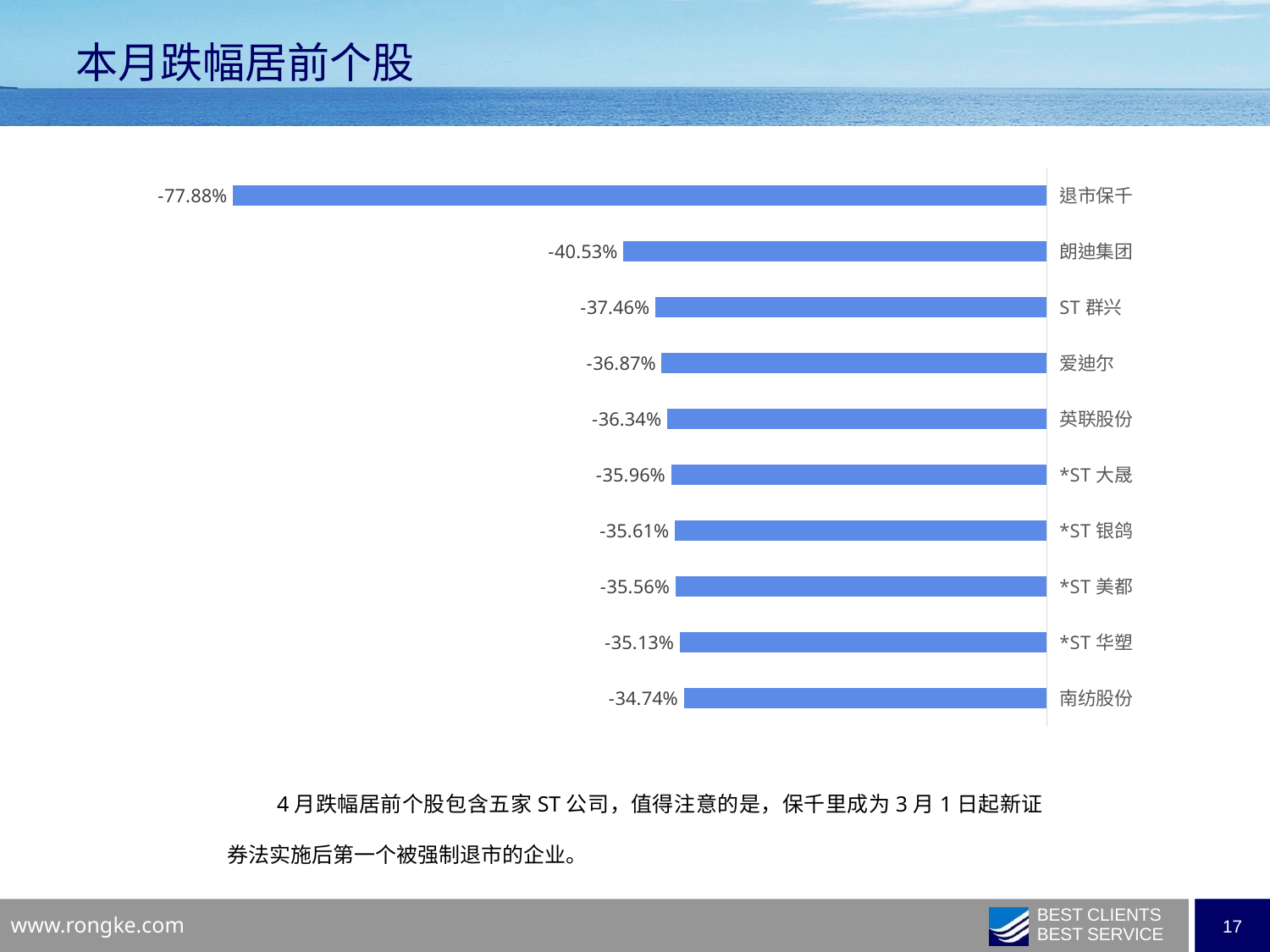
Which stock has the smallest decline (the highest value) on the chart? 南纺股份 What is the title of the slide? 本月跌幅居前个股 Which stock has the largest decline (the lowest value) on the chart? 退市保千 What is the value shown for *ST 银鸽? -35.61% What kind of chart is shown on the slide? Bar chart What is the value shown for 退市保千? -77.88% How many stocks are shown on the chart? 10 What is the value shown for 朗迪集团? -40.53% What is the difference in percentage points between the values for 退市保千 (-77.88%) and 朗迪集团 (-40.53%)? 37.35 percentage points What is the value shown for 南纺股份? -34.74% Do the bars get longer or shorter going from the top of the chart to the bottom? Shorter Which stock had the larger decline, 朗迪集团 or ST 群兴? 朗迪集团